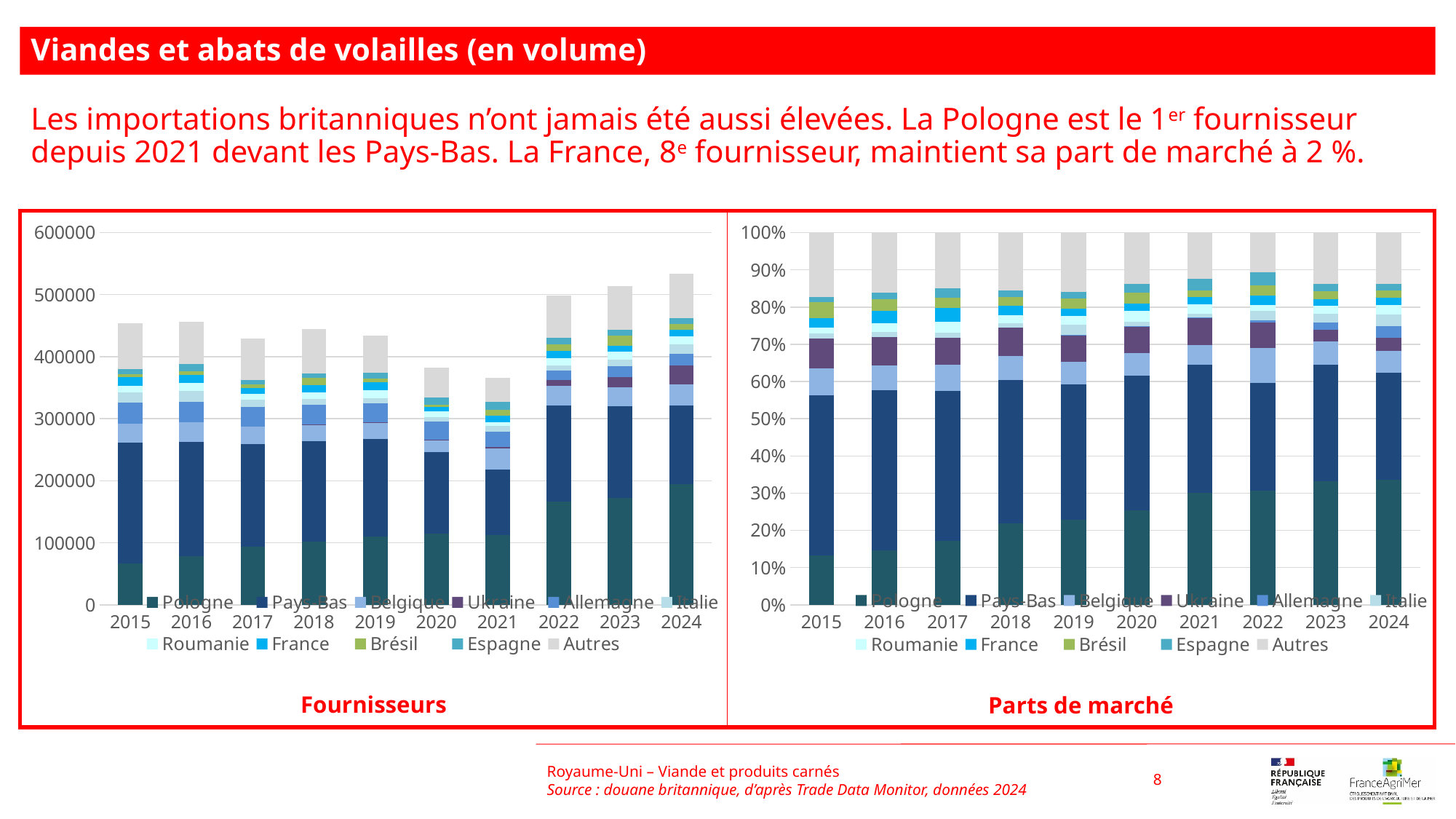
In the 'Parts de marché' chart, does the Pologne share generally rise or fall from 2015 to 2024? rise How many years are shown on the x axis of the 'Parts de marché' chart? 10 In the 'Fournisseurs' chart, is the Pologne segment larger in 2015 or in 2024? 2024 How many series does the legend of the 'Fournisseurs' chart list? 11 In the 'Fournisseurs' chart, which year has the highest total bar? 2024 In the 'Fournisseurs' chart, which year has the lowest total bar? 2021 In the 'Fournisseurs' chart, is the total bar for 2021 greater or less than 400000? less In the 'Fournisseurs' chart, is the total bar for 2024 greater or less than 500000? greater In the 'Parts de marché' chart, is the Pologne share for 2024 greater or less than 30%? greater What kind of chart is the 'Fournisseurs' chart on the left? stacked bar chart Which series is shown in light grey at the top of the bars in both charts? Autres